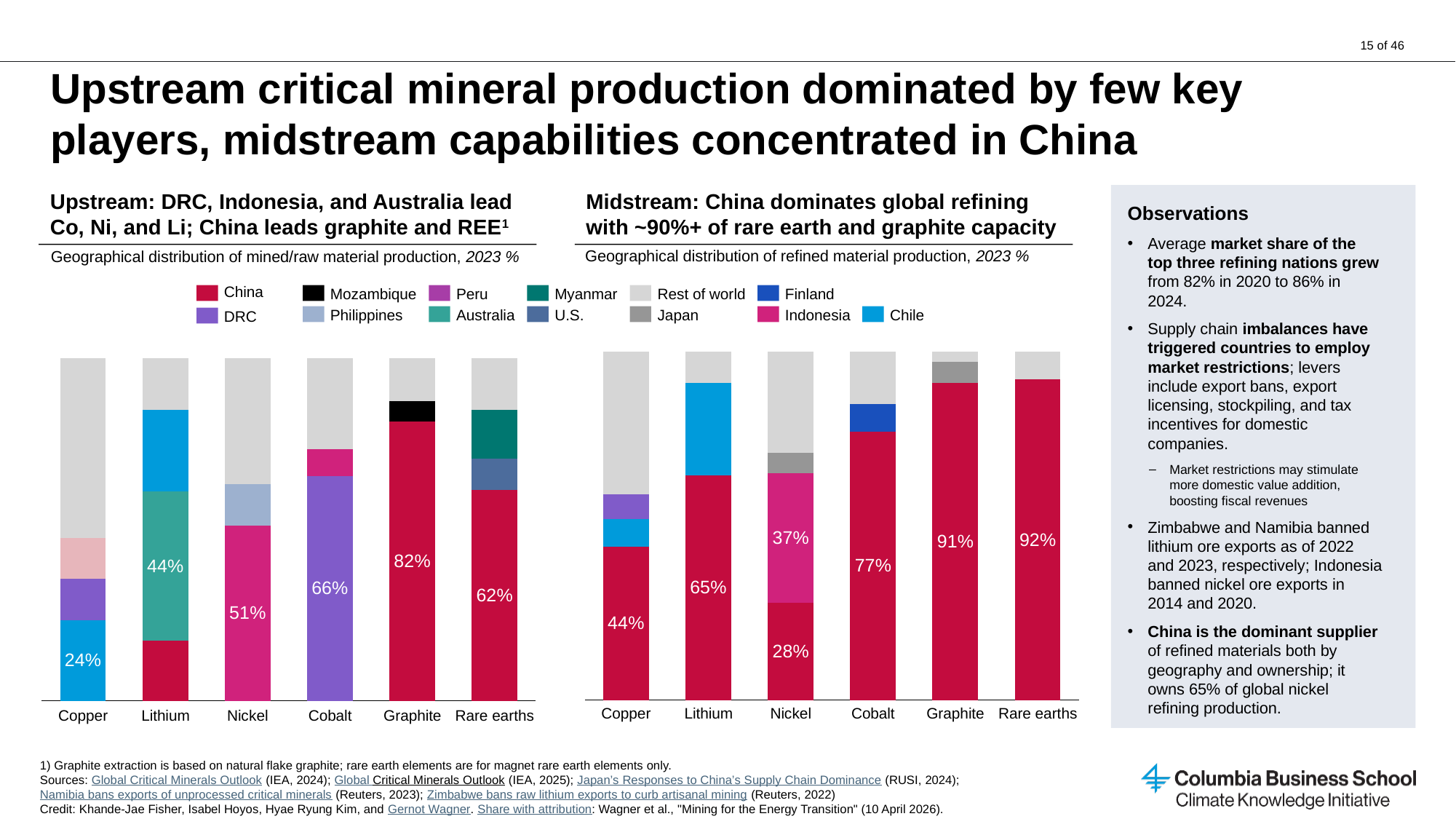
In the Midstream chart, which mineral has the lowest labelled China share? Nickel In the Upstream chart, what is the difference between China's labelled share for graphite and for rare earths? 20% In the Upstream chart, what is the labelled share for Chile in mined copper production? 24% In the Midstream chart, which mineral has the highest labelled China share? Rare earths In the Midstream chart, what is China's share of refined graphite production? 91% In the Midstream chart, which is larger: China's share of refined copper or China's share of refined lithium? Lithium In the Midstream chart, what is Indonesia's labelled share of refined nickel production? 37% In the Upstream chart, what is the labelled share for DRC in mined cobalt production? 66% What type of chart is used for the Midstream geographical distribution of refined material production? Stacked bar chart How many countries or regions does the shared legend list? 13 How many minerals are shown on the x axis of the Upstream chart? 6 In the Midstream chart, what is China's share of refined rare earths production? 92%